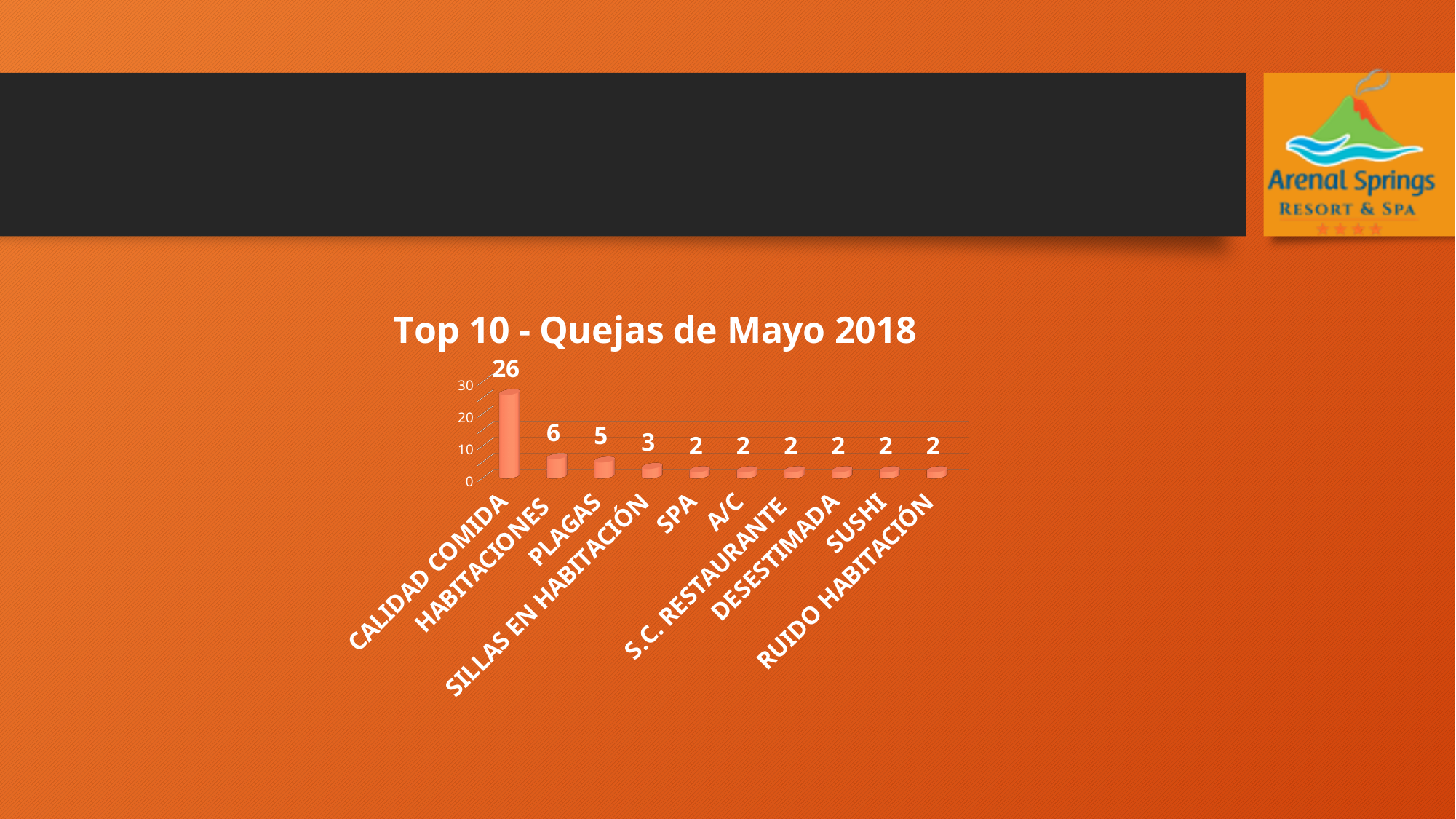
Is the value for CALIDAD COMIDA greater or less than 20? greater What is the value for SPA? 2 How many categories are shown on the chart? 10 Which is larger, the value for PLAGAS or the value for SILLAS EN HABITACIÓN? PLAGAS Which category has the highest value? CALIDAD COMIDA What is the difference between the values for CALIDAD COMIDA and HABITACIONES? 20 What is the value for PLAGAS? 5 What kind of chart is shown on the slide? Bar chart What is the value for CALIDAD COMIDA? 26 What is the value for SILLAS EN HABITACIÓN? 3 What is the value for HABITACIONES? 6 What is the title of the chart? Top 10 - Quejas de Mayo 2018